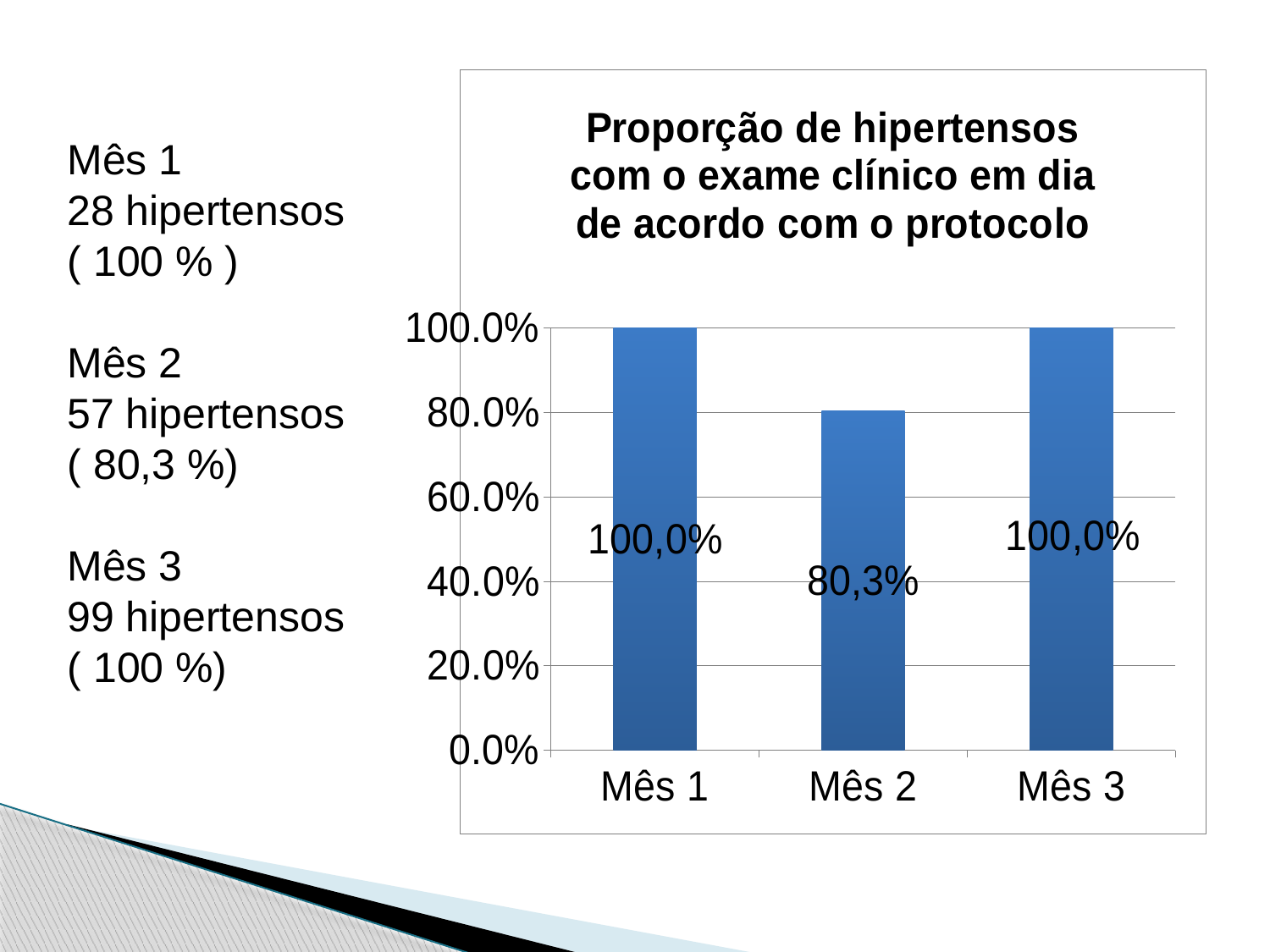
What is the difference between the values for Mês 1 and Mês 2? 19,7% What is the value for Mês 2 in the chart? 80,3% Is the value for Mês 1 greater or less than 80.0%? greater What is the value for Mês 1 in the chart? 100,0% Does the value fall or rise from Mês 1 to Mês 2? fall What kind of chart is shown on the slide? bar chart Which month has the lowest value in the chart? Mês 2 What is the title of the chart? Proporção de hipertensos com o exame clínico em dia de acordo com o protocolo How many categories are shown on the x axis of the chart? 3 What is the value for Mês 3 in the chart? 100,0% Is the value for Mês 2 greater or less than 60.0%? greater Which is larger, the value for Mês 2 or the value for Mês 3? Mês 3